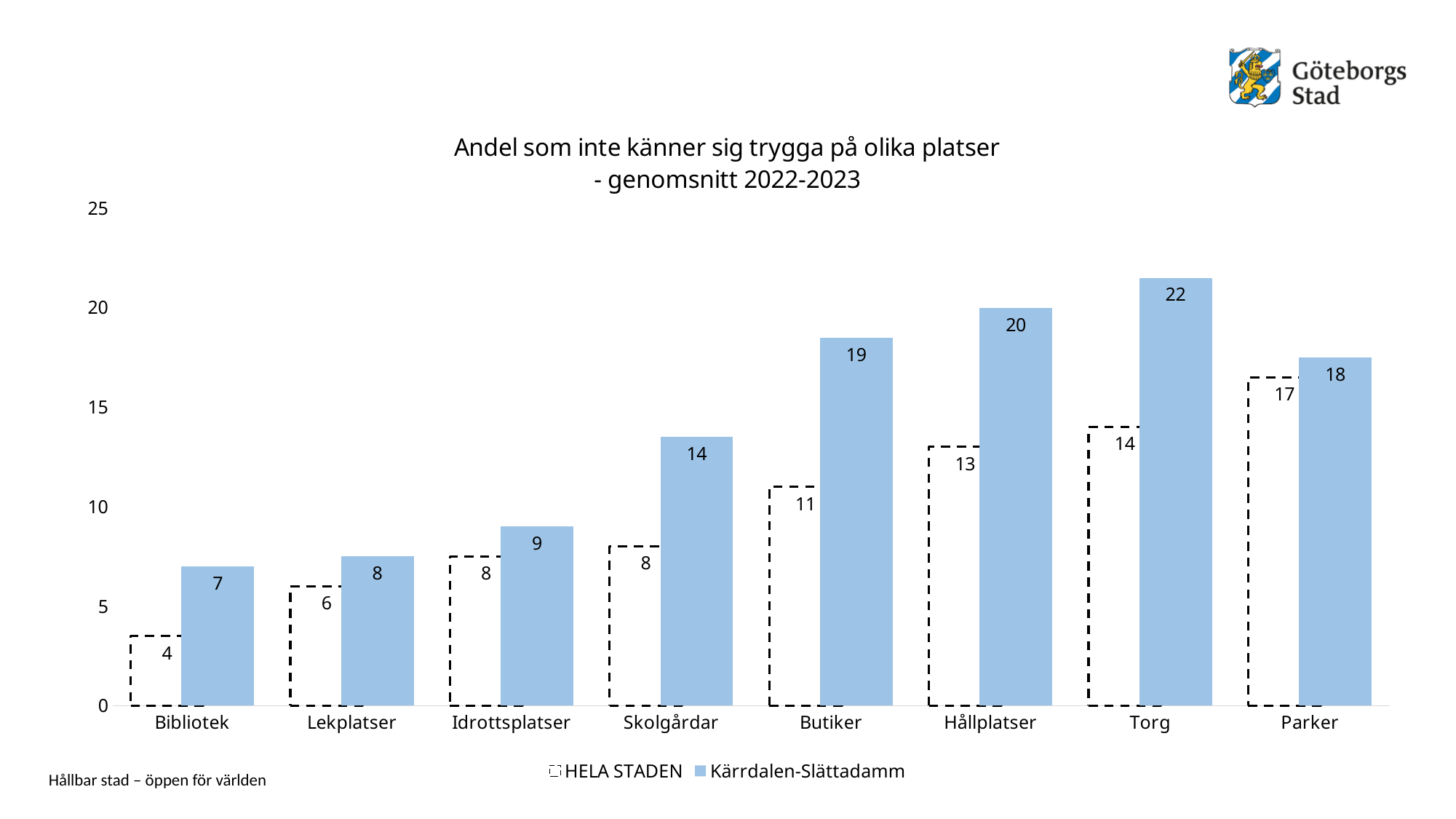
Which category has the highest value for Kärrdalen-Slättadamm? Torg Which category has the lowest value for HELA STADEN? Bibliotek What is the difference between Kärrdalen-Slättadamm and HELA STADEN at Butiker? 8 What is the title of the chart? Andel som inte känner sig trygga på olika platser - genomsnitt 2022-2023 What kind of chart is shown? Bar chart Which is larger at Hållplatser: HELA STADEN or Kärrdalen-Slättadamm? Kärrdalen-Slättadamm What is the value for HELA STADEN at Bibliotek? 4 What is the value for Kärrdalen-Slättadamm at Butiker? 19 How many categories are shown on the x axis? 8 What is the value for Kärrdalen-Slättadamm at Torg? 22 How many series does the legend list? 2 What is the value for HELA STADEN at Parker? 17